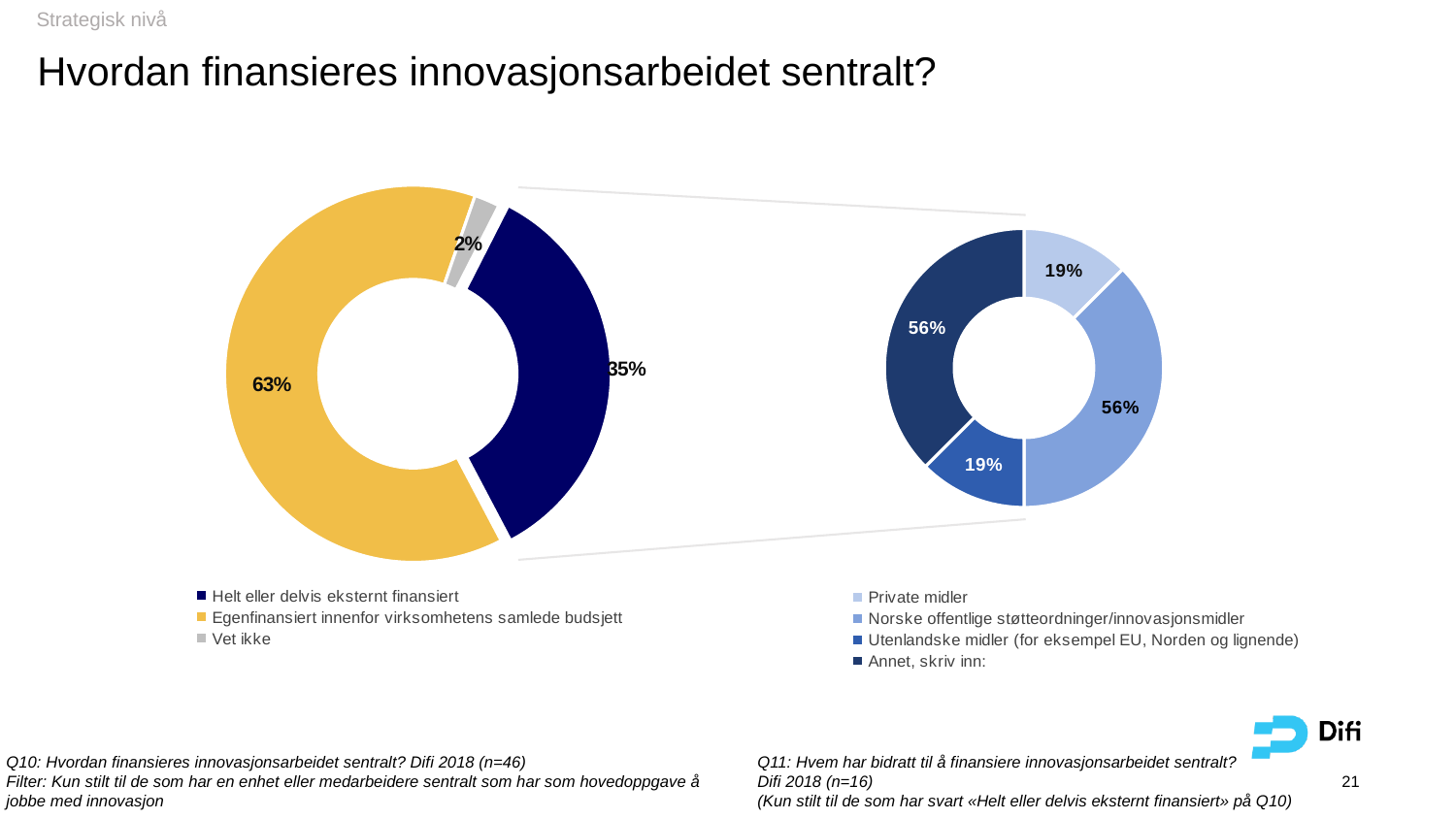
In the right chart (Q11), what percentage is shown for 'Norske offentlige støtteordninger/innovasjonsmidler'? 56% In the right chart (Q11), is the value for 'Annet, skriv inn:' larger or smaller than the value for 'Private midler'? larger What type of chart is used on the left side of the slide (Q10)? Doughnut chart In the right chart (Q11), what percentage is shown for 'Private midler'? 19% In the right chart (Q11), what percentage is shown for 'Utenlandske midler (for eksempel EU, Norden og lignende)'? 19% In the left chart (Q10), what is the difference in percentage points between 'Egenfinansiert innenfor virksomhetens samlede budsjett' and 'Helt eller delvis eksternt finansiert'? 28 percentage points How many categories does the legend of the right chart (Q11) list? 4 In the left chart (Q10), what percentage is shown for 'Helt eller delvis eksternt finansiert'? 35% In the left chart (Q10), what percentage is shown for 'Egenfinansiert innenfor virksomhetens samlede budsjett'? 63% In the left chart (Q10), which category has the largest share? Egenfinansiert innenfor virksomhetens samlede budsjett In the left chart (Q10), what percentage is shown for 'Vet ikke'? 2% In the left chart (Q10), which category has the smallest share? Vet ikke